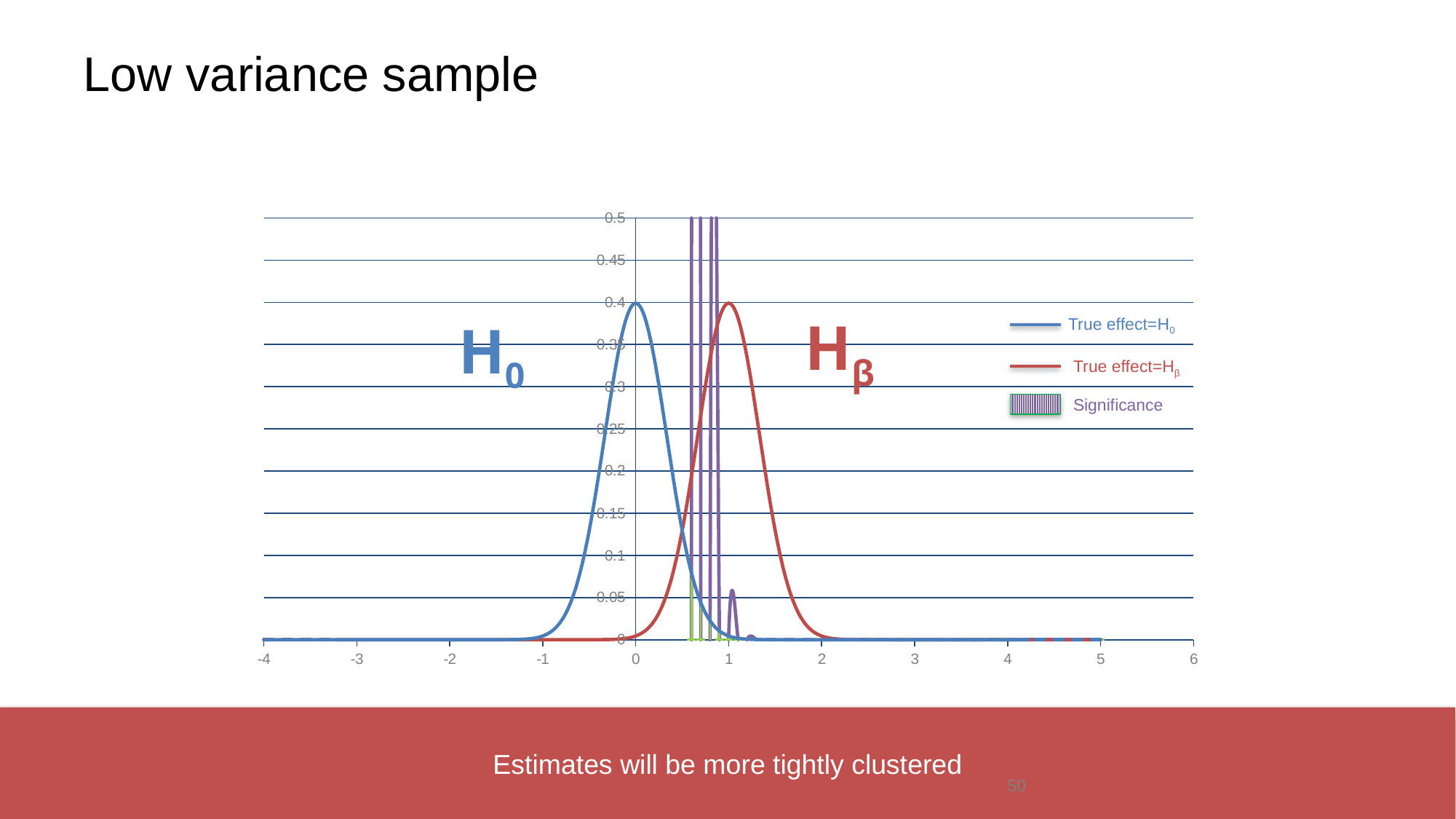
Is the value of the red 'True effect=Hβ' curve at x = 0 greater or less than 0.05? less How many series does the legend list? 3 Is the peak value of the blue 'True effect=H0' curve greater or less than 0.3? greater At which x-axis value does the red 'True effect=Hβ' curve reach its peak? 1 At which x-axis value does the blue 'True effect=H0' curve reach its peak? 0 What is the title of the slide containing the chart? Low variance sample At x = -0.5, which curve is higher: the blue 'True effect=H0' curve or the red 'True effect=Hβ' curve? True effect=H0 Does the blue 'True effect=H0' curve rise or fall as x goes from 0 to 1? Fall Is the peak value of the red 'True effect=Hβ' curve greater or less than 0.45? less Which colour is used for the 'True effect=H0' series? Blue What kind of chart is shown on the slide? Line chart At x = 1.5, which curve is higher: the blue 'True effect=H0' curve or the red 'True effect=Hβ' curve? True effect=Hβ